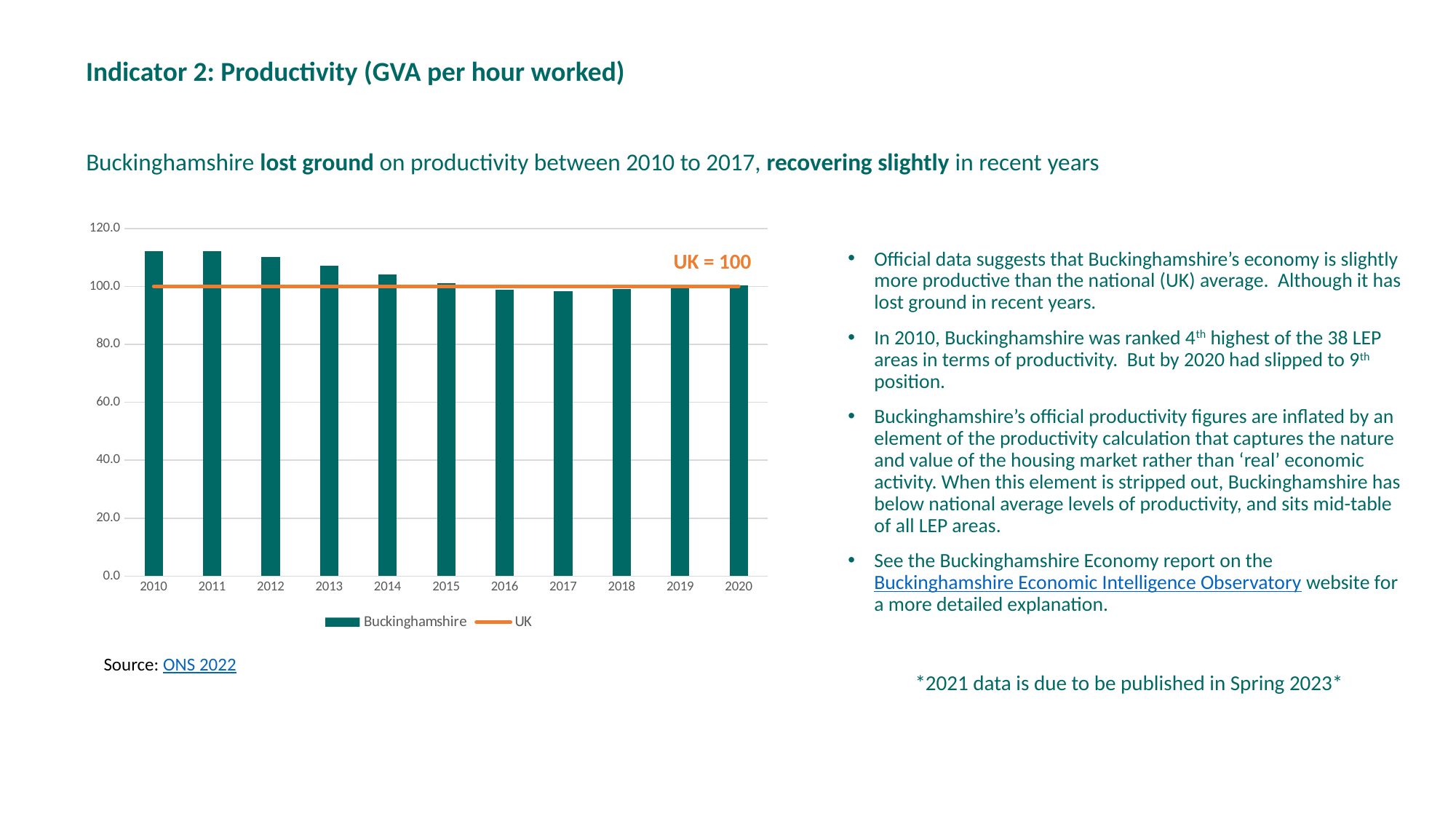
Is the value for Buckinghamshire in 2010 greater or less than 100? greater Is the value for Buckinghamshire in 2012 greater or less than 100? greater What value does the UK line sit at in the chart? 100 What is the first series listed in the chart legend? Buckinghamshire Do the Buckinghamshire values rise or fall between 2010 and 2017? fall What kind of chart is shown on the slide? bar chart Is the value for Buckinghamshire in 2017 greater or less than 100? less Which series is shown as an orange line in the chart? UK How many years are shown on the x axis of the chart? 11 Which is larger, the Buckinghamshire value for 2010 or for 2017? 2010 How many series does the chart legend list? 2